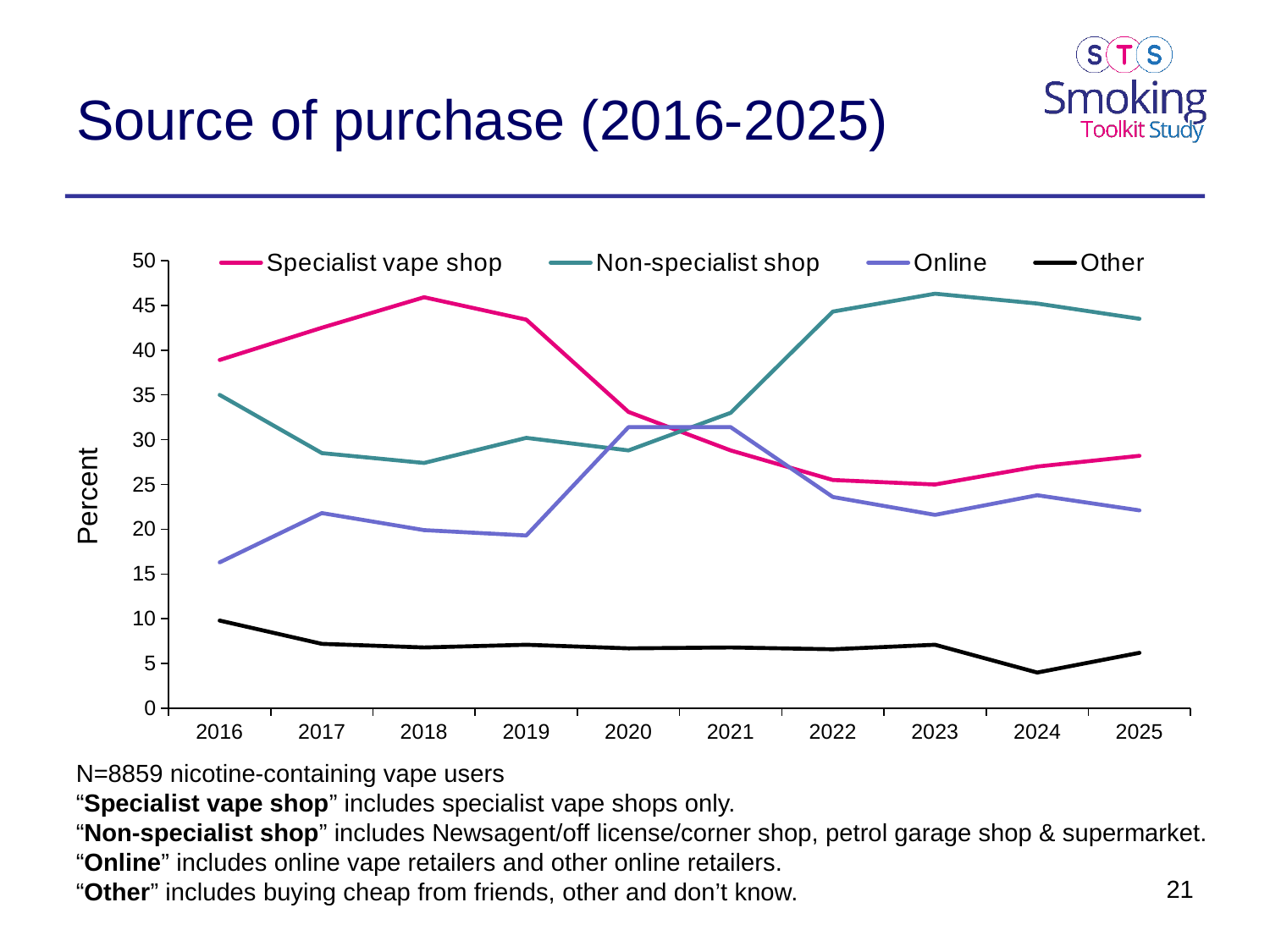
What kind of chart is shown on the slide? line chart In 2025, which is larger: Non-specialist shop or Specialist vape shop? Non-specialist shop Is the value for Specialist vape shop in 2016 greater or less than 35? greater In which year does the Other line reach its lowest value? 2024 In which year does the Specialist vape shop line reach its highest value? 2018 What is the label on the y axis? Percent Does the Other line rise or fall from 2016 to 2024? fall How many years are plotted along the x axis? 10 Which series has the highest value in 2023? Non-specialist shop Is the value for Online in 2016 greater or less than 20? less How many series does the legend list? 4 Is the value for Non-specialist shop in 2023 greater or less than 40? greater